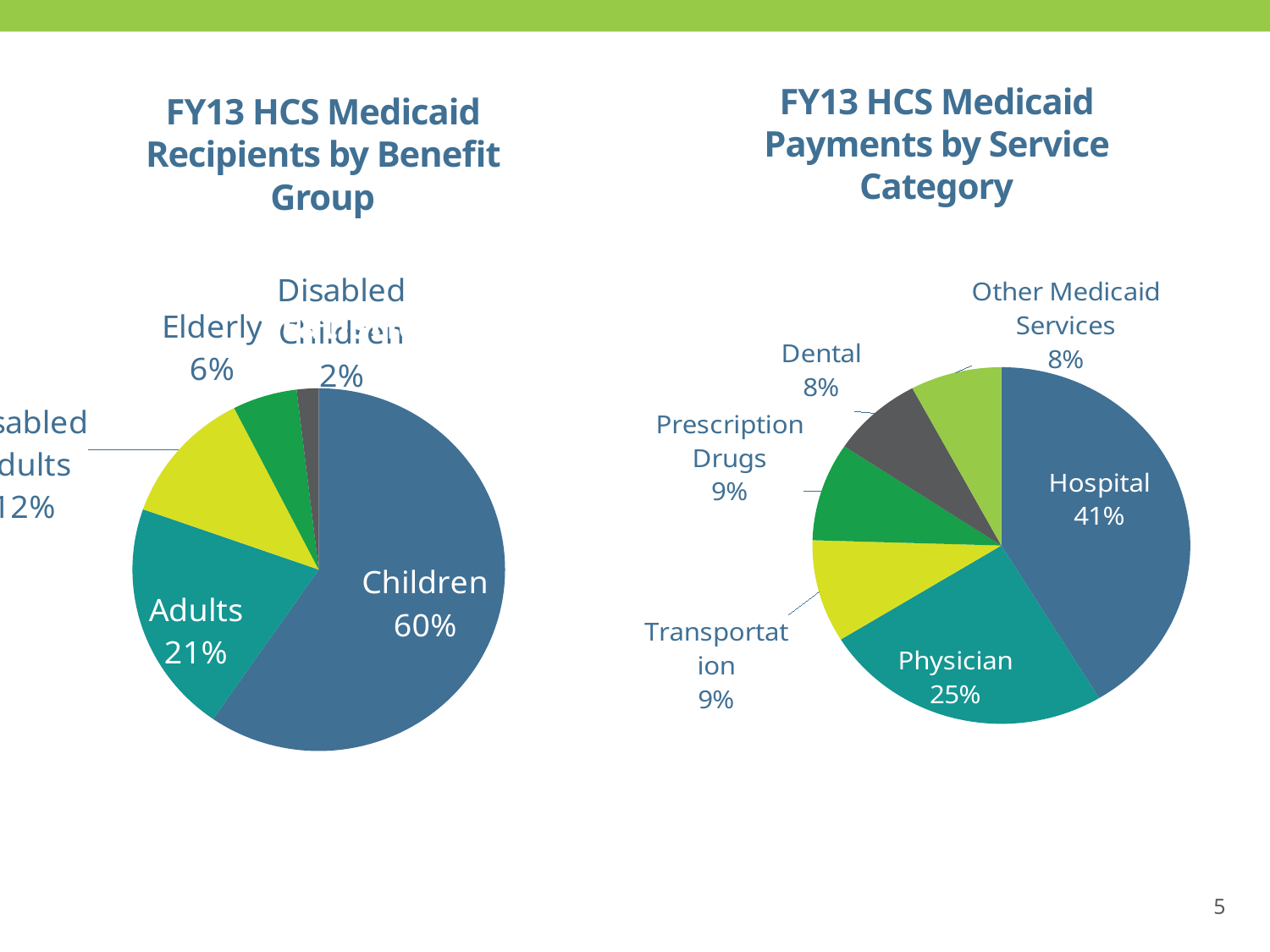
In the FY13 HCS Medicaid Payments by Service Category chart, what percentage is shown for Physician? 25% In the FY13 HCS Medicaid Payments by Service Category chart, how many service categories are shown? 6 In the FY13 HCS Medicaid Recipients by Benefit Group chart, how many percentage points larger is the Children share than the Adults share? 39 In the FY13 HCS Medicaid Payments by Service Category chart, which is larger, Hospital or Physician? Hospital In the FY13 HCS Medicaid Recipients by Benefit Group chart, what percentage is shown for Adults? 21% In the FY13 HCS Medicaid Payments by Service Category chart, what share of payments goes to Hospital? 41% In the FY13 HCS Medicaid Recipients by Benefit Group chart, which benefit group has the largest share? Children In the FY13 HCS Medicaid Recipients by Benefit Group chart, what share of recipients are Children? 60% What type of chart is the FY13 HCS Medicaid Payments by Service Category chart? Pie chart In the FY13 HCS Medicaid Recipients by Benefit Group chart, which benefit group has the smallest share? Disabled Children In the FY13 HCS Medicaid Payments by Service Category chart, what percentage is shown for Dental? 8% In the FY13 HCS Medicaid Recipients by Benefit Group chart, what percentage is shown for Elderly? 6%